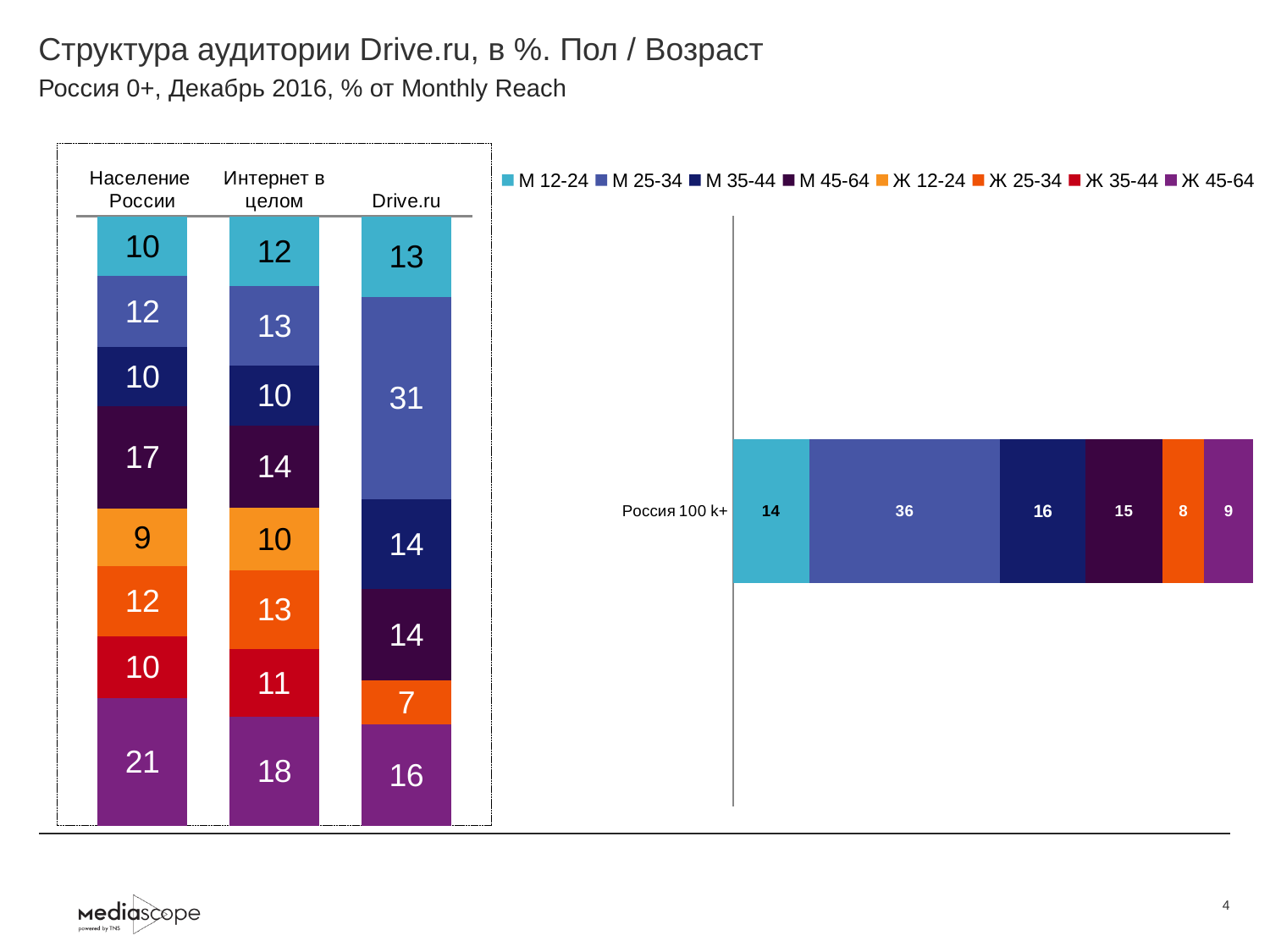
In the right chart (Россия 100 k+), what is the value for М 25-34? 36 How many bars (categories) does the left chart show? 3 In the left chart, what is the value for М 45-64 in the Интернет в целом bar? 14 In the left chart, which series has the largest segment in the Drive.ru bar? М 25-34 In the right chart (Россия 100 k+), which series has the largest segment? М 25-34 In the left chart, what is the value for Ж 45-64 in the Население России bar? 21 In the right chart (Россия 100 k+), what is the value for М 12-24? 14 How many series does the legend list? 8 In the left chart, what is the difference between the М 25-34 value for Drive.ru and the М 25-34 value for Население России? 19 In the left chart, which bar has the larger Ж 45-64 value: Население России or Интернет в целом? Население России What kind of chart is the left chart? Stacked bar chart In the left chart, what is the value for М 25-34 in the Drive.ru bar? 31